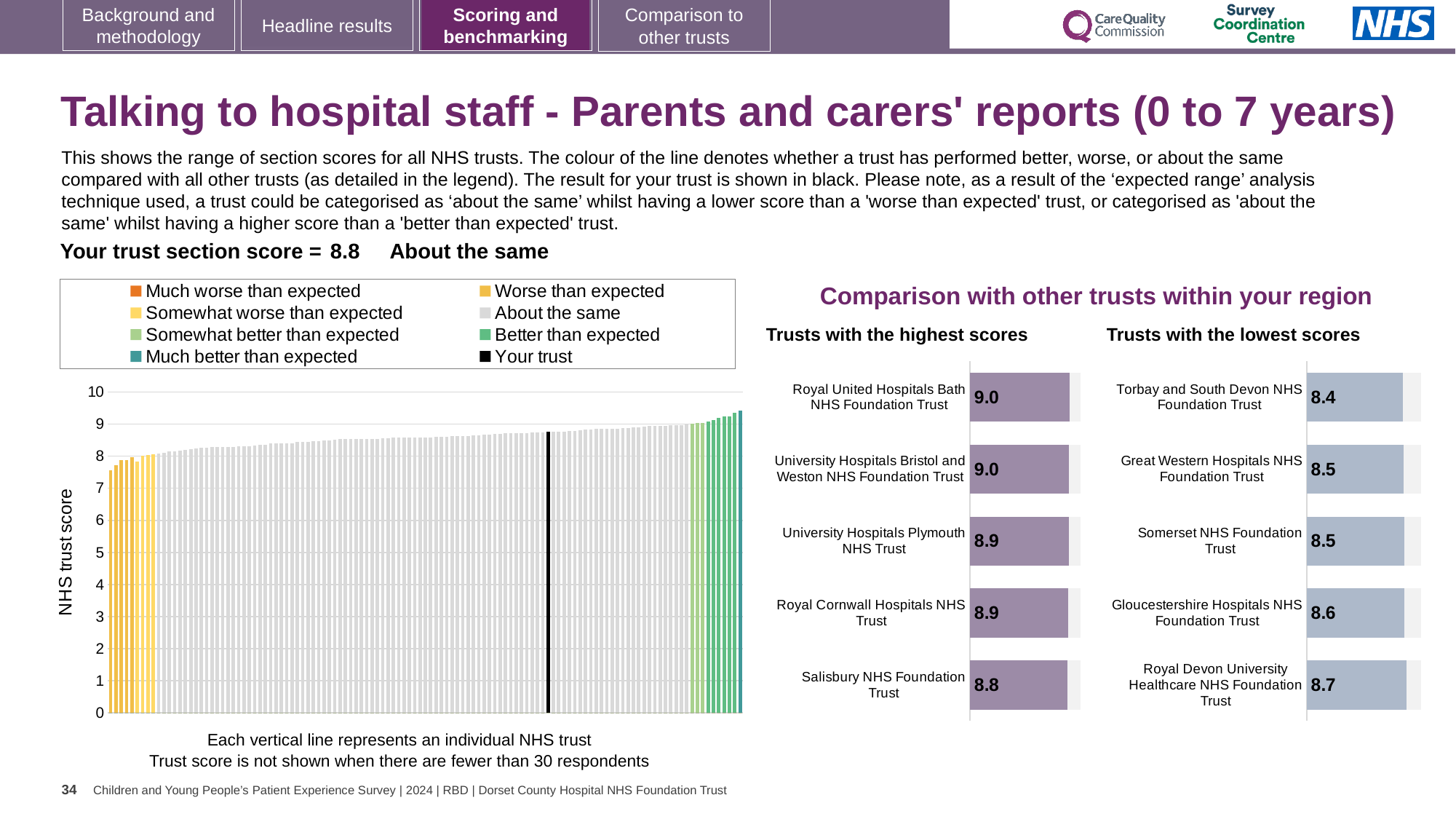
In the 'Trusts with the lowest scores' chart, which trust has the highest score? Royal Devon University Healthcare NHS Foundation Trust How many trusts are shown in the 'Trusts with the highest scores' chart? 5 In the 'Trusts with the highest scores' chart, what is the difference between the scores of Royal United Hospitals Bath NHS Foundation Trust and Salisbury NHS Foundation Trust? 0.2 In the large chart on the left, do the trust scores rise or fall from left to right? Rise In the 'Trusts with the lowest scores' chart, what is the difference between the scores of Royal Devon University Healthcare NHS Foundation Trust and Torbay and South Devon NHS Foundation Trust? 0.3 In the large chart on the left, what is the score of the trust shown in black (your trust)? 8.8 In the 'Trusts with the lowest scores' chart, which has the higher score: Gloucestershire Hospitals NHS Foundation Trust or Great Western Hospitals NHS Foundation Trust? Gloucestershire Hospitals NHS Foundation Trust In the 'Trusts with the lowest scores' chart, which trust has the lowest score? Torbay and South Devon NHS Foundation Trust In the 'Trusts with the lowest scores' chart, what is the score for Torbay and South Devon NHS Foundation Trust? 8.4 What kind of chart is the large chart on the left showing NHS trust scores? Bar chart How many entries does the legend above the large chart on the left list? 8 In the 'Trusts with the highest scores' chart, what is the score for Salisbury NHS Foundation Trust? 8.8